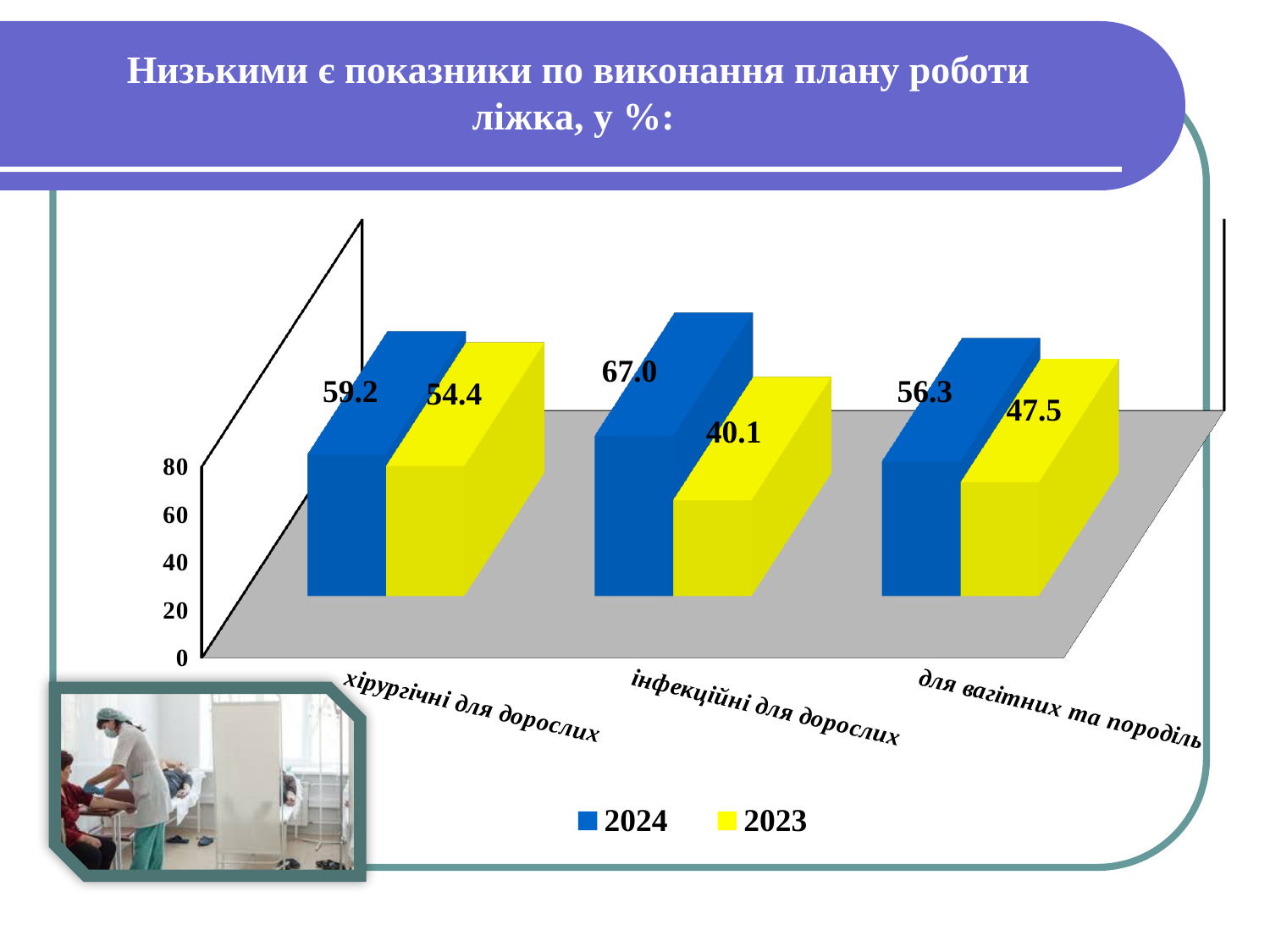
What is the value for 2023 for для вагітних та породіль? 47.5 What kind of chart is shown on the slide? bar chart Which is larger for хірургічні для дорослих: the 2024 value or the 2023 value? 2024 Which category has the lowest value for 2023? інфекційні для дорослих What is the value for 2024 for хірургічні для дорослих? 59.2 Which category has the highest value for 2024? інфекційні для дорослих Which colour represents the 2023 series in the legend? yellow What is the value for 2024 for для вагітних та породіль? 56.3 How many series does the legend list? 2 What is the value for 2023 for інфекційні для дорослих? 40.1 How many categories are shown on the x axis? 3 What is the difference between the 2024 and 2023 values for інфекційні для дорослих? 26.9